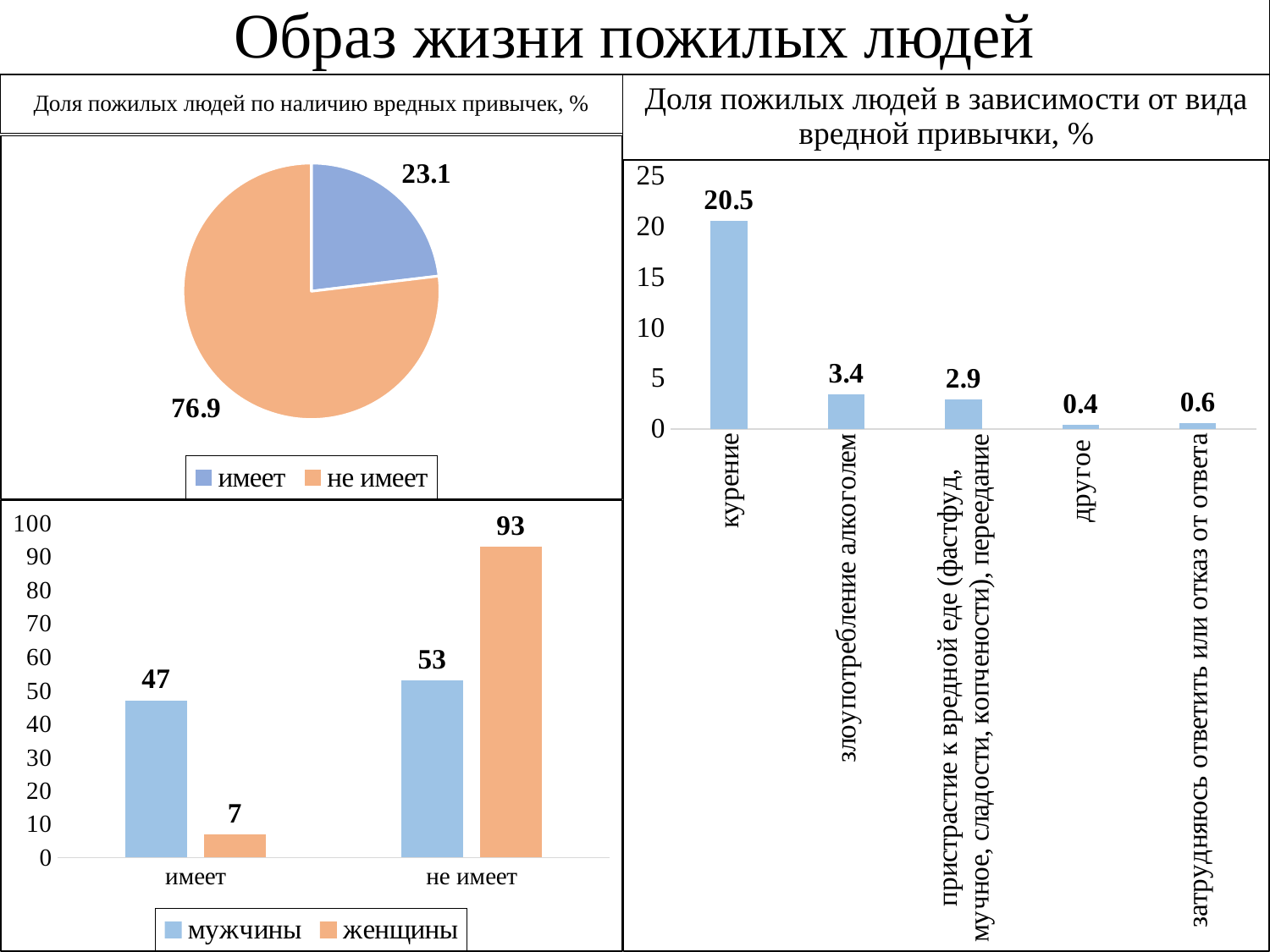
In the bar chart at the bottom left, what is the value for 'мужчины' in the 'не имеет' category? 53 In the chart 'Доля пожилых людей в зависимости от вида вредной привычки, %', which category has the highest value? курение In the bar chart at the bottom left, what is the value for 'женщины' in the 'имеет' category? 7 In the chart 'Доля пожилых людей в зависимости от вида вредной привычки, %', what is the value for 'злоупотребление алкоголем'? 3.4 In the pie chart 'Доля пожилых людей по наличию вредных привычек, %', which slice is larger, 'имеет' or 'не имеет'? не имеет In the chart 'Доля пожилых людей в зависимости от вида вредной привычки, %', which category has the lowest value? другое In the pie chart 'Доля пожилых людей по наличию вредных привычек, %', what is the value for 'имеет'? 23.1 In the bar chart at the bottom left, what is the difference between 'женщины' and 'мужчины' in the 'не имеет' category? 40 In the pie chart 'Доля пожилых людей по наличию вредных привычек, %', what is the value for 'не имеет'? 76.9 In the pie chart 'Доля пожилых людей по наличию вредных привычек, %', how many slices are there? 2 In the bar chart at the bottom left, how many series does the legend list? 2 What kind of chart is 'Доля пожилых людей в зависимости от вида вредной привычки, %'? bar chart